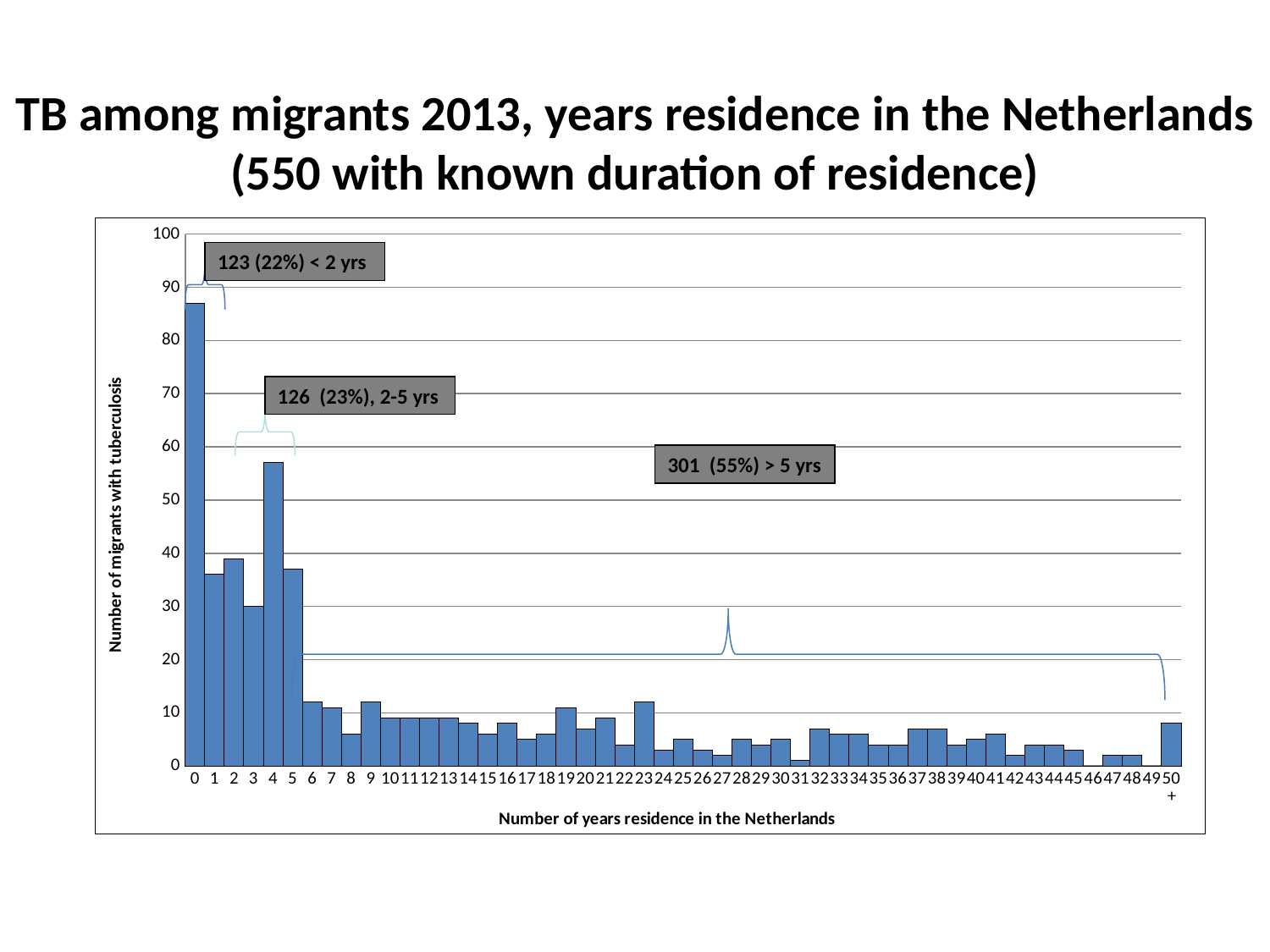
Which has more migrants with tuberculosis: 4 years residence or 2 years residence? 4 years residence Is the value for 4 years residence greater or less than 50? greater Is the value for 50+ years residence greater or less than 10? less Is the value for 31 years residence greater or less than 10? less According to the annotation, how many migrants had more than 5 years residence? 301 (55%) Which has more migrants with tuberculosis: 0 years residence or 4 years residence? 0 years residence According to the annotation, how many migrants had less than 2 years residence? 123 (22%) Which number of years residence has the highest number of migrants with tuberculosis? 0 What is the label of the vertical axis? Number of migrants with tuberculosis What kind of chart is shown on the slide? bar chart